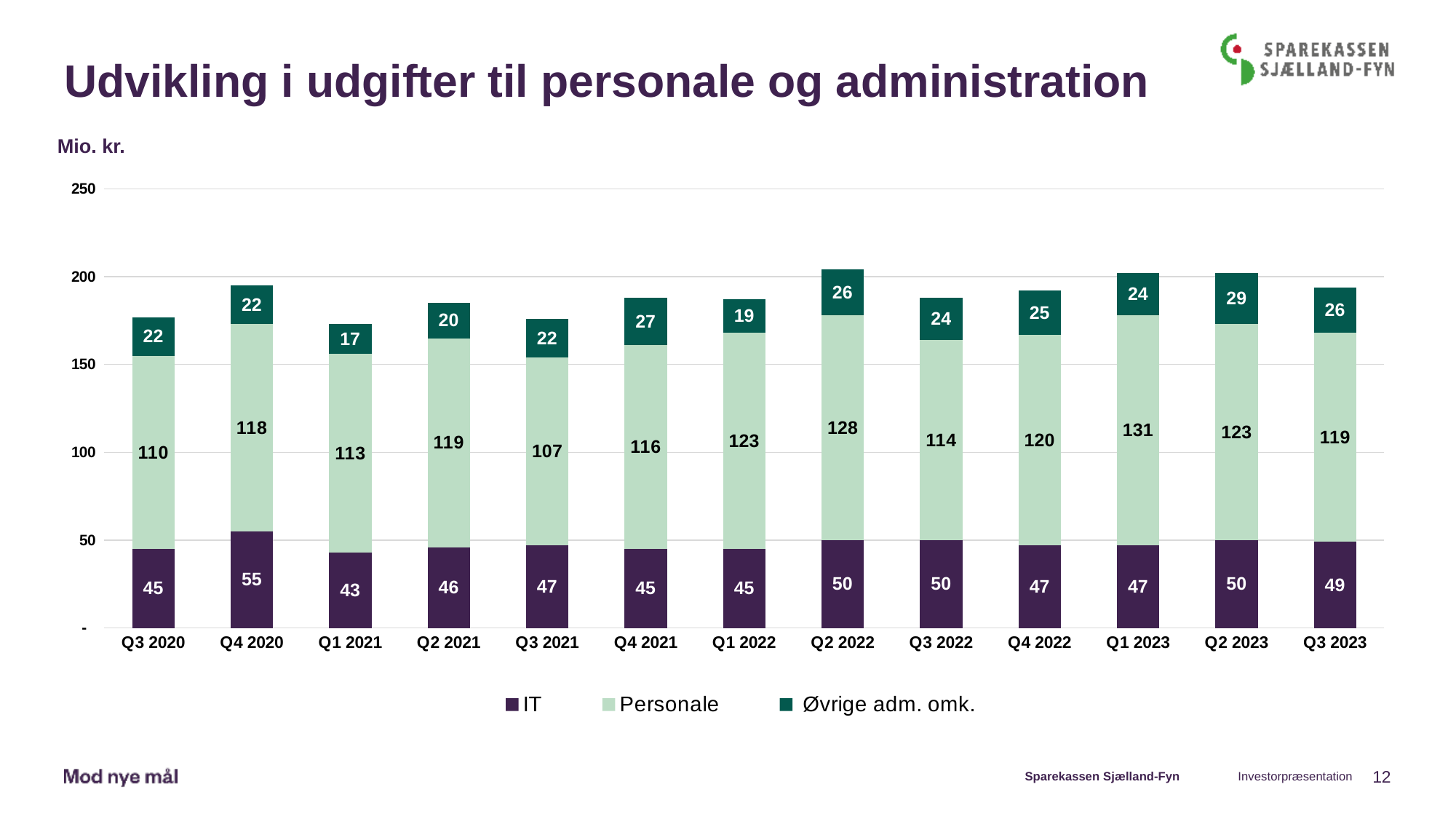
Which quarter has the highest Personale value? Q1 2023 What is the difference between the Personale values for Q2 2022 and Q3 2022? 14 How many series does the legend list? 3 How many quarters are shown on the x axis? 13 What is the total of the stacked bar for Q3 2023? 194 What is the Personale value for Q1 2023? 131 Which quarter has the lowest Øvrige adm. omk. value? Q1 2021 What kind of chart is shown on the slide? Stacked bar chart What is the total of the stacked bar for Q2 2022? 204 Which is larger, the IT value for Q4 2020 or the IT value for Q1 2021? Q4 2020 What is the IT value for Q4 2020? 55 What is the Øvrige adm. omk. value for Q2 2023? 29